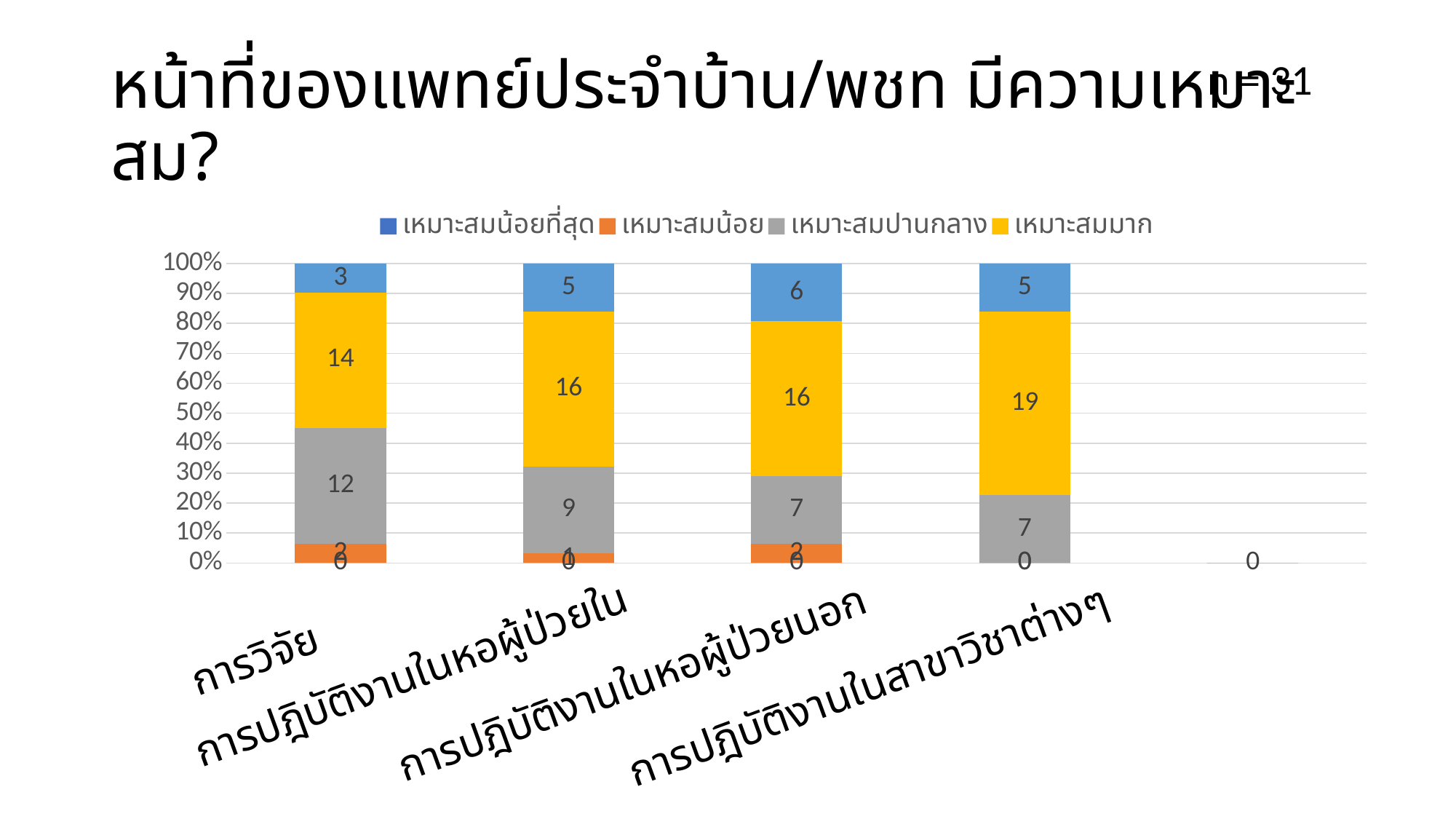
Which has a larger เหมาะสมปานกลาง value: การวิจัย or การปฏิบัติงานในหอผู้ป่วยนอก? การวิจัย Which category has the highest value for เหมาะสมมาก? การปฏิบัติงานในสาขาวิชาต่างๆ What is the value of เหมาะสมน้อย for การปฏิบัติงานในหอผู้ป่วยใน? 1 What is the difference in เหมาะสมมาก between การปฏิบัติงานในสาขาวิชาต่างๆ and การวิจัย? 5 What kind of chart is shown on the slide? Stacked bar chart Which category has the highest value for เหมาะสมปานกลาง? การวิจัย How many series does the legend list? 4 What is the value of เหมาะสมมาก for การปฏิบัติงานในสาขาวิชาต่างๆ? 19 What colour represents เหมาะสมมาก in the chart? Yellow How many labelled categories are shown on the x axis? 4 What is the value of เหมาะสมมาก for การวิจัย? 14 What is the value of เหมาะสมปานกลาง for การปฏิบัติงานในหอผู้ป่วยใน? 9